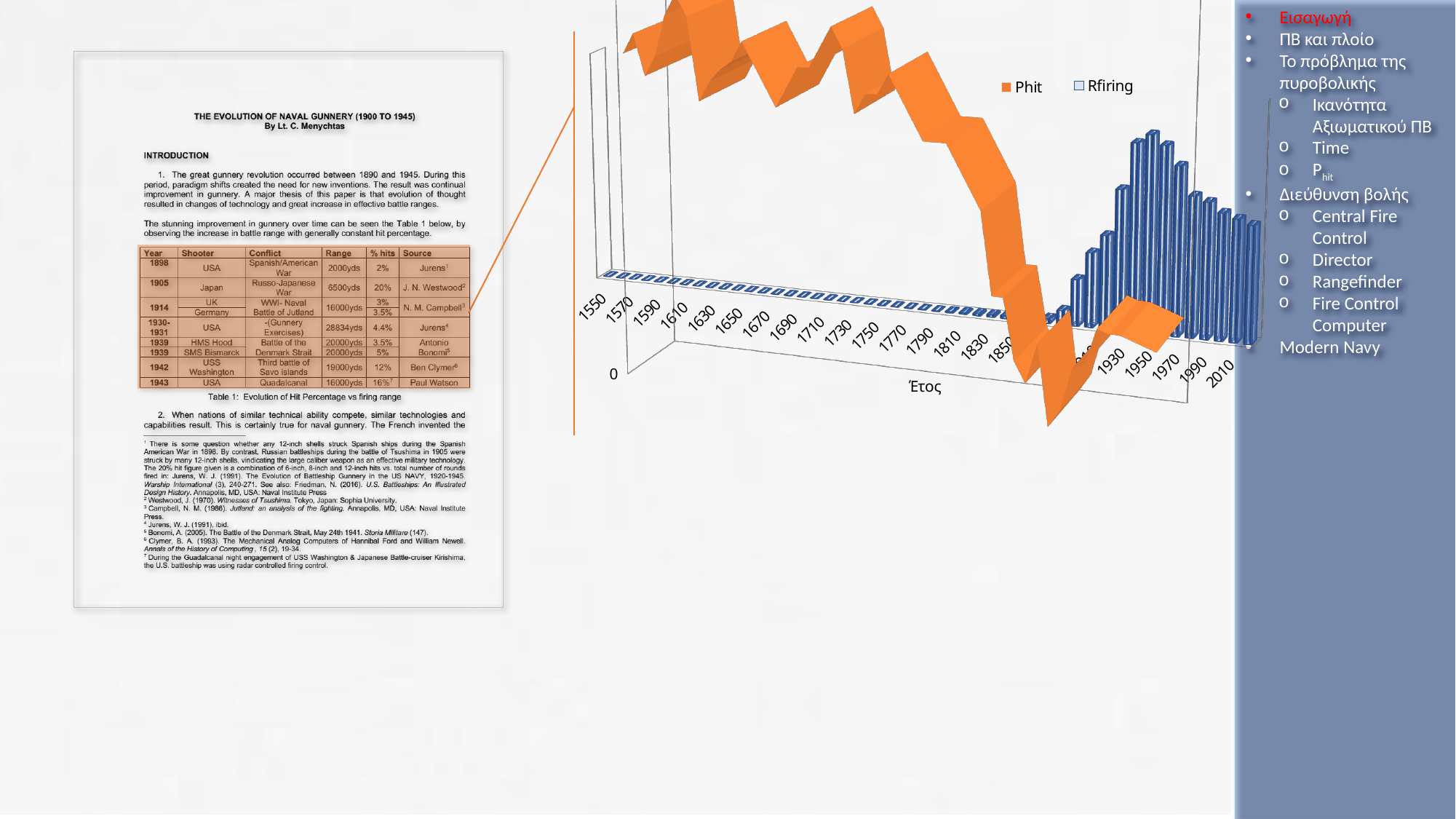
Is the Rfiring value larger around 2010 or around 1550? around 2010 Which series is shown in orange in the chart? Phit How many series does the chart's legend list? 2 What are the names of the two series in the chart's legend? Phit and Rfiring What is the first year label on the chart's horizontal axis? 1550 What is the title of the chart's horizontal axis? Έτος What is the last year label on the chart's horizontal axis? 2010 Which series is drawn as vertical bars in the chart? Rfiring How many years apart are consecutive labels on the chart's horizontal axis? 20 Does the Phit series generally rise or fall from 1550 toward 1850? fall